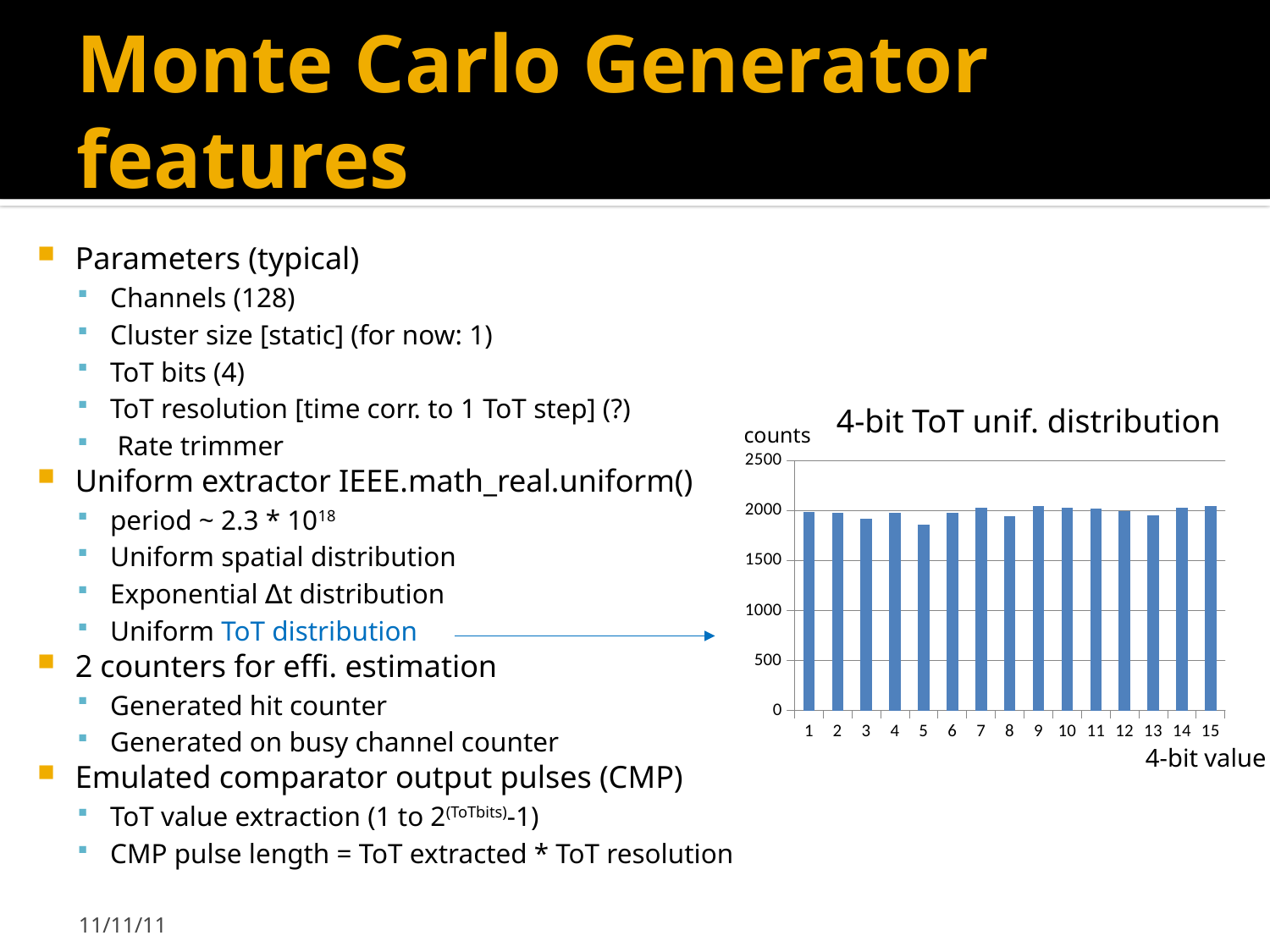
Is the count for 4-bit value 3 greater or less than 2000? less Which has the larger count, 4-bit value 7 or 4-bit value 5? 7 What kind of chart is shown on the slide? bar chart Which has the larger count, 4-bit value 5 or 4-bit value 9? 9 Is the count for 4-bit value 9 greater or less than 1500? greater Is the count for 4-bit value 5 greater or less than 2000? less How many 4-bit values (categories) are plotted on the x axis of the chart? 15 What label is given to the vertical axis of the chart? counts Which 4-bit value has the lowest count in the chart? 5 What is the highest tick value shown on the vertical axis of the chart? 2500 What is the title of the chart on the slide? 4-bit ToT unif. distribution